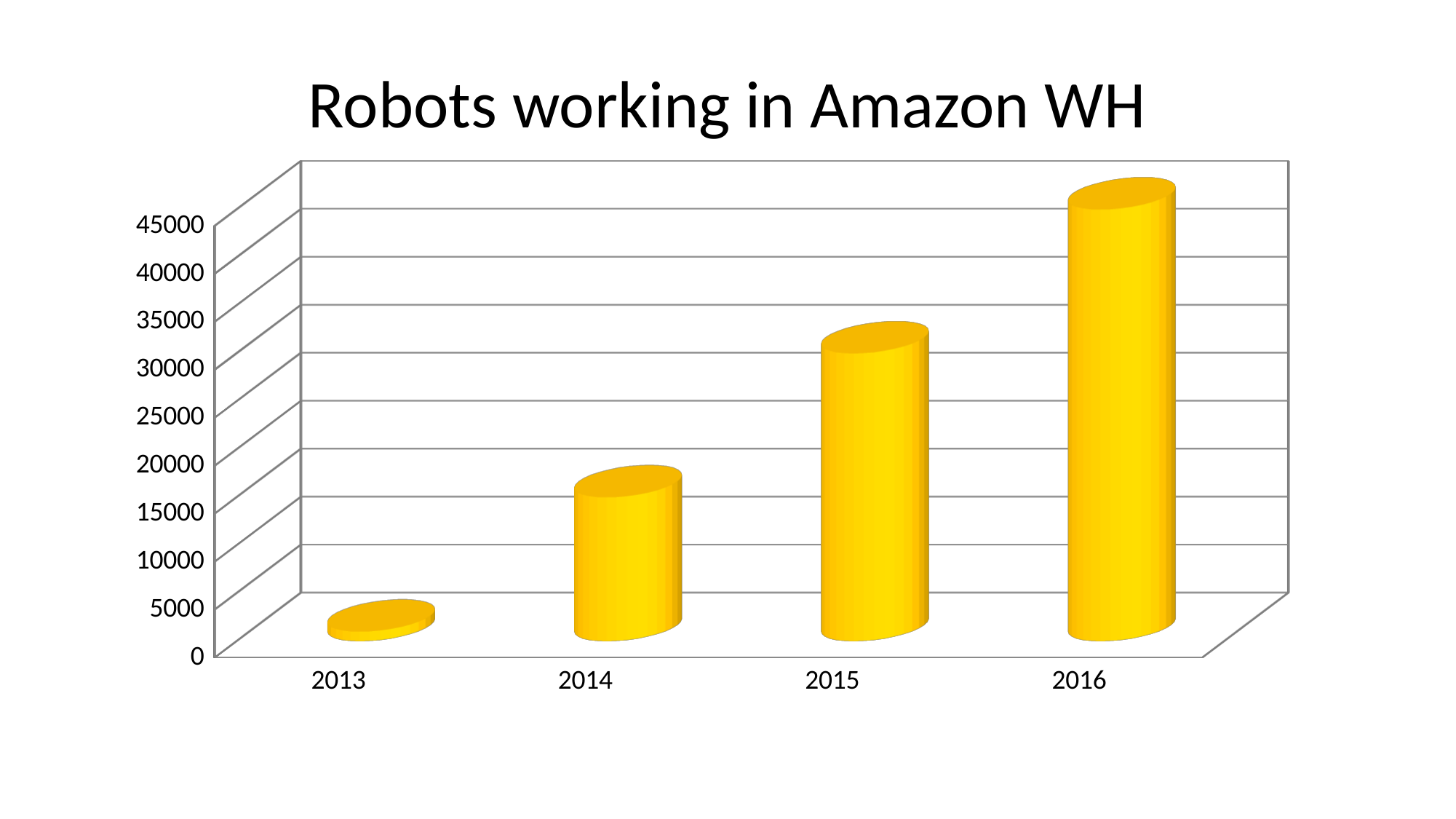
Is the value for 2015 greater or less than 25000? greater What colour are the bars in the chart? yellow Which year has the highest number of robots working in Amazon WH? 2016 Is the value for 2013 greater or less than 5000? less What kind of chart is shown on the slide? bar chart Is the value for 2016 greater or less than 40000? greater Which year has the lowest number of robots working in Amazon WH? 2013 How many years are shown on the x axis of the chart? 4 Do the values rise or fall from 2013 to 2016? rise Which year has a larger value, 2014 or 2015? 2015 What is the title of the chart? Robots working in Amazon WH